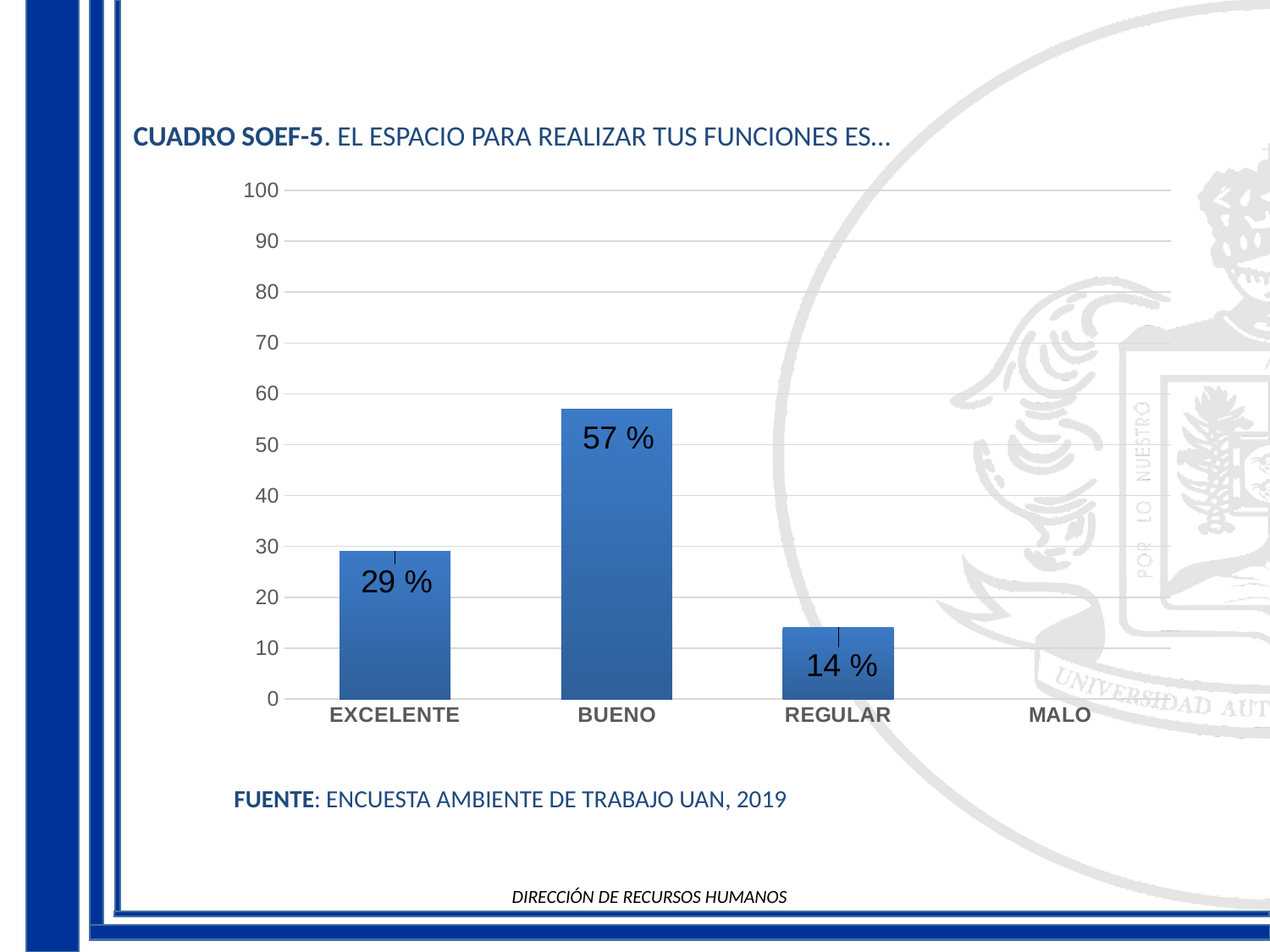
Which category with a visible bar has the lowest value? REGULAR What is the difference between the values for BUENO and EXCELENTE? 28 % What is the value for EXCELENTE? 29 % Which is larger, the value for EXCELENTE or the value for REGULAR? EXCELENTE What is the difference between the values for EXCELENTE and REGULAR? 15 % Which category has the highest value? BUENO What is the value for BUENO? 57 % What kind of chart is shown on the slide? bar chart What is the source cited below the chart? ENCUESTA AMBIENTE DE TRABAJO UAN, 2019 How many categories are shown on the x axis? 4 What is the value for REGULAR? 14 % Is the value for BUENO greater or less than 50? greater